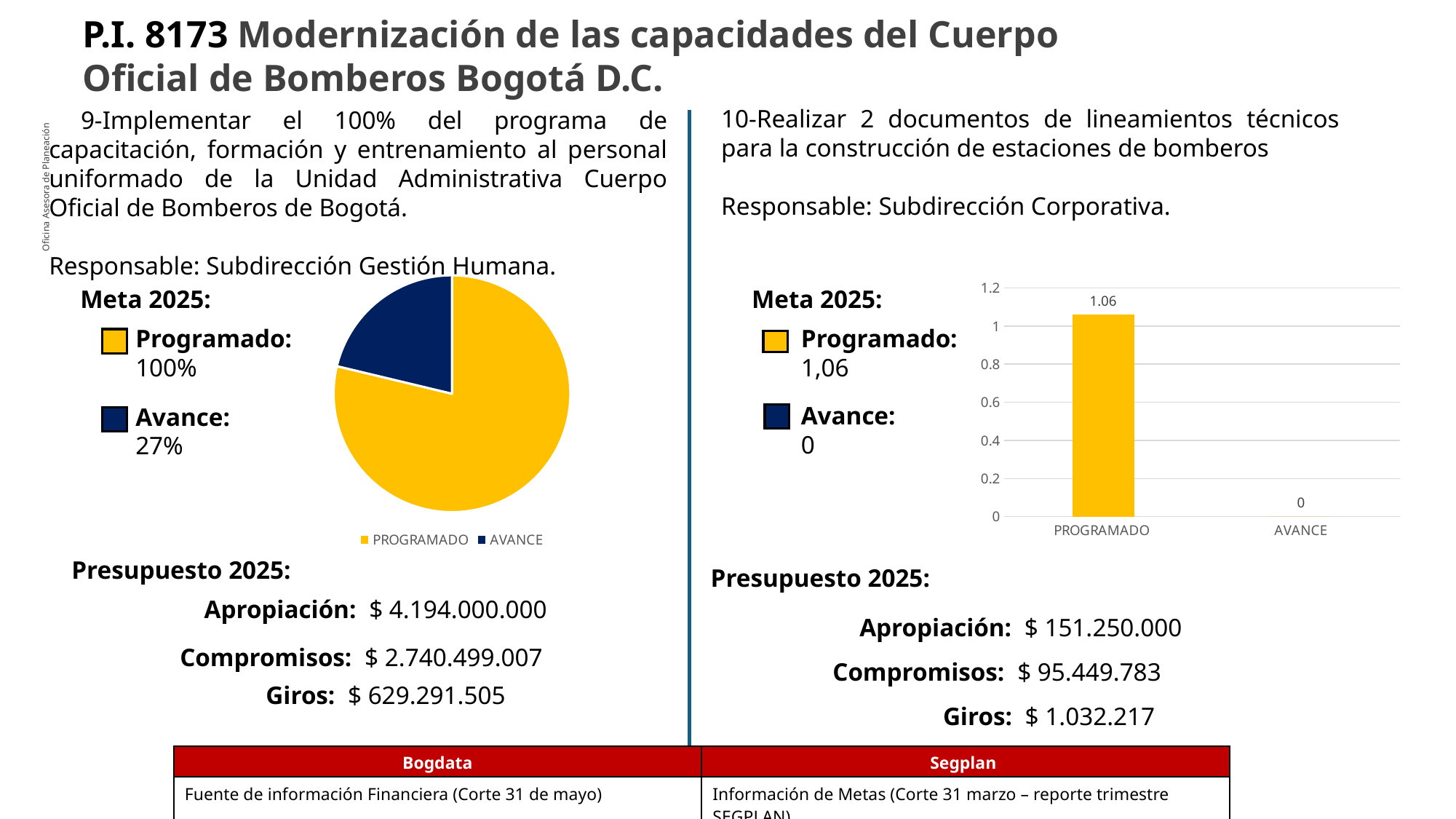
In the bar chart on the right, what is the value for PROGRAMADO? 1.06 In the pie chart on the left, what colour is the AVANCE slice? dark blue In the pie chart on the left, which slice is larger, PROGRAMADO or AVANCE? PROGRAMADO In the bar chart on the right, is the value for PROGRAMADO greater or less than 1? greater How many slices does the pie chart on the left have? 2 In the bar chart on the right, what is the value for AVANCE? 0 In the bar chart on the right, what is the difference between the PROGRAMADO and AVANCE values? 1.06 How many entries does the legend of the pie chart on the left list? 2 In the bar chart on the right, which category has the highest value? PROGRAMADO What kind of chart is the chart on the right side of the slide? bar chart What kind of chart is the chart on the left side of the slide? pie chart In the bar chart on the right, which category has the lowest value? AVANCE